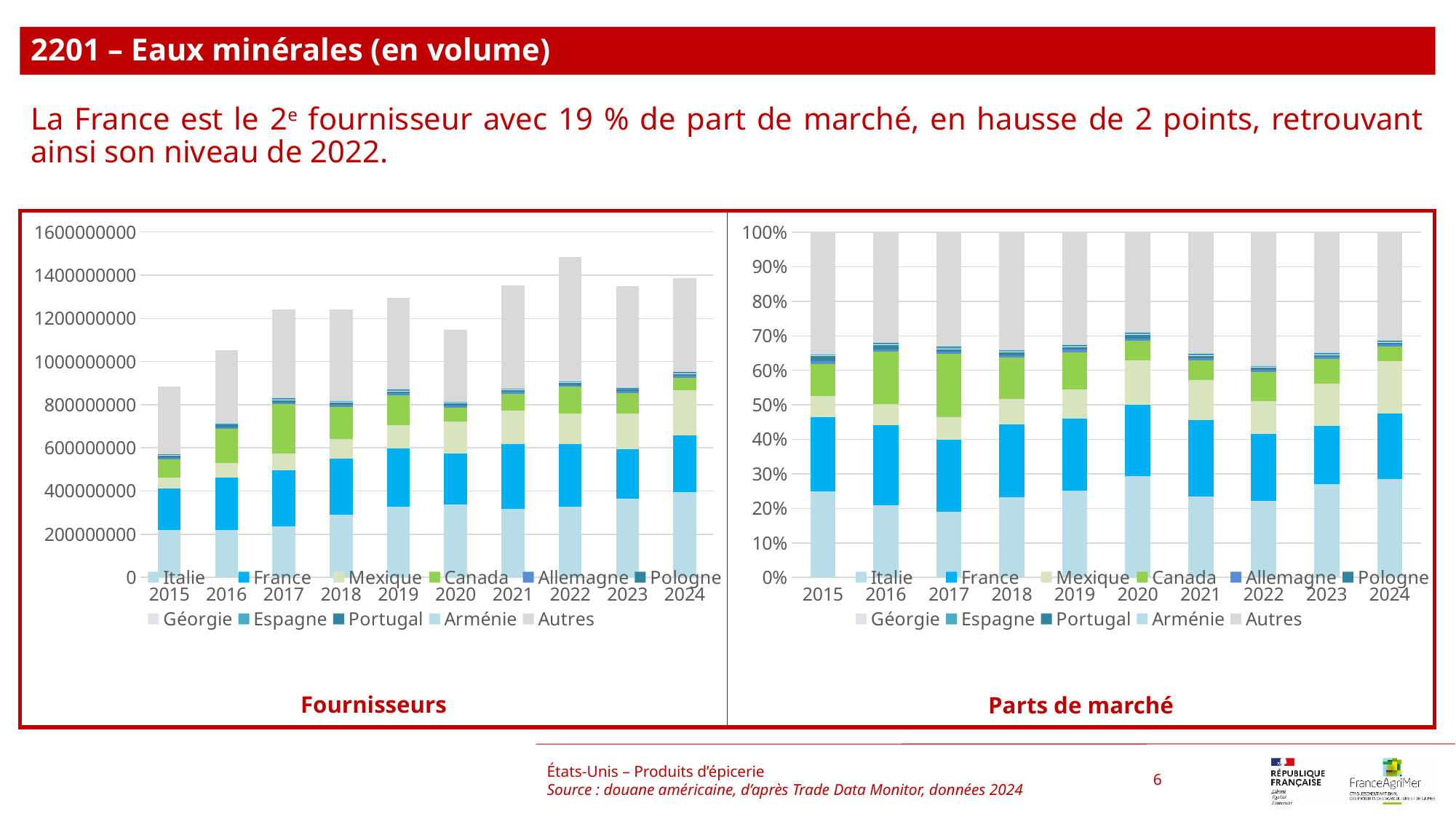
How many years are shown on the x axis of the "Parts de marché" chart? 10 In the "Fournisseurs" chart, which year has the tallest total bar? 2022 In the "Fournisseurs" chart, which year has the shortest total bar? 2015 In the "Fournisseurs" chart, is the total bar for 2015 greater or less than 1000000000? less In the "Parts de marché" chart, is the Italie share for 2020 greater or less than 20%? greater What is the title of the chart on the right side of the slide? Parts de marché How many series does the legend of the "Fournisseurs" chart list? 11 In the "Fournisseurs" chart, is the total bar for 2022 greater or less than 1400000000? greater In the "Fournisseurs" chart, is the total bar for 2022 larger or smaller than the total bar for 2023? larger In the "Fournisseurs" chart, do the total bars generally rise or fall from 2015 to 2024? rise In the "Fournisseurs" chart, which total bar is larger, 2016 or 2017? 2017 What kind of chart is the "Fournisseurs" chart on the left? stacked bar chart